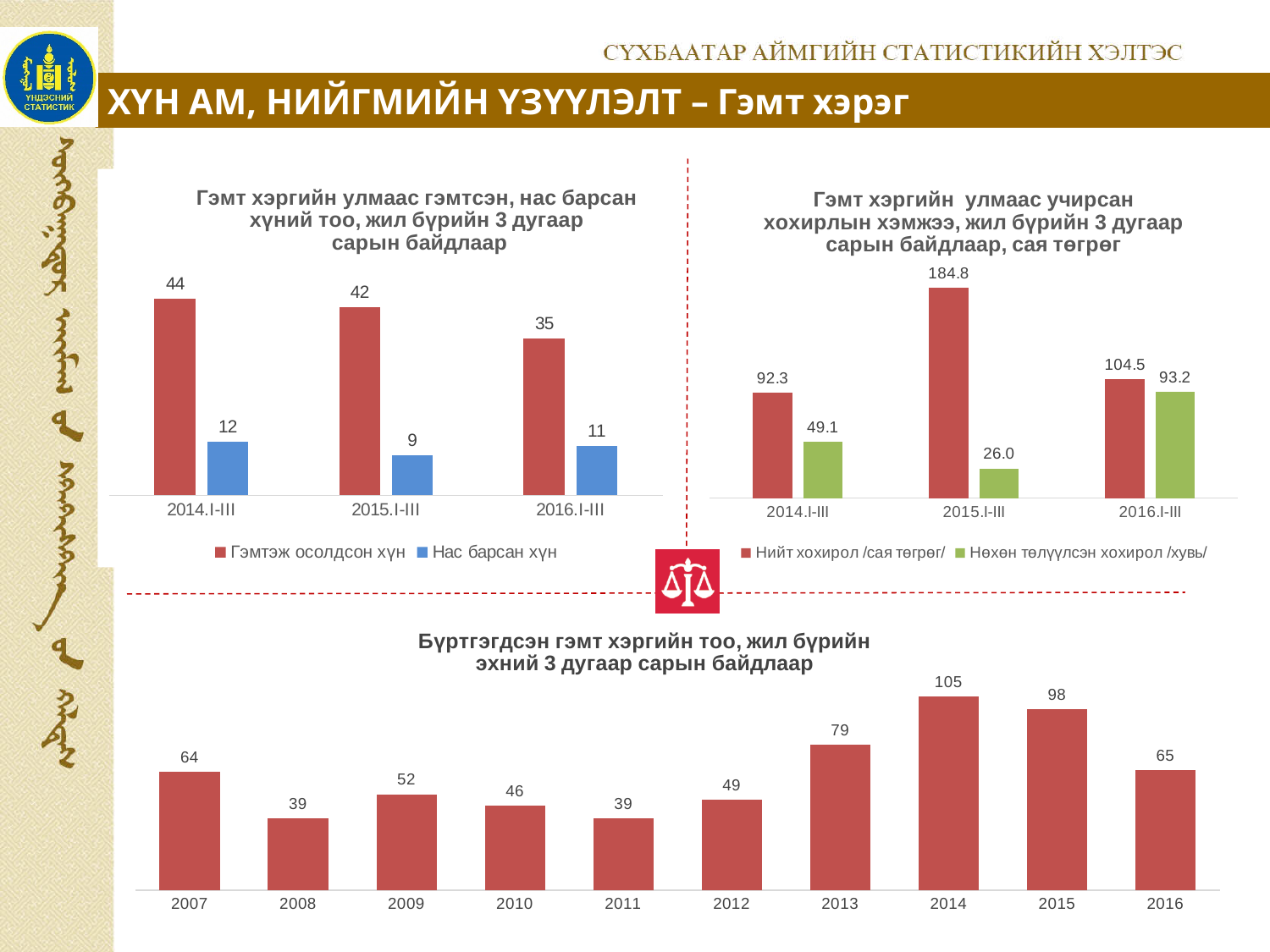
In the top-left chart (Гэмт хэргийн улмаас гэмтсэн, нас барсан хүний тоо), how many series does the legend list? 2 What kind of chart is the bottom chart (Бүртгэгдсэн гэмт хэргийн тоо)? Bar chart In the top-left chart (Гэмт хэргийн улмаас гэмтсэн, нас барсан хүний тоо), what is the difference between Гэмтэж осолдсон хүн and Нас барсан хүн in 2016.I-III? 24 In the top-right chart (Гэмт хэргийн улмаас учирсан хохирлын хэмжээ), in which period is Нөхөн төлүүлсэн хохирол the lowest? 2015.I-III In the top-right chart (Гэмт хэргийн улмаас учирсан хохирлын хэмжээ), what is the value for Нийт хохирол in 2015.I-III? 184.8 In the top-left chart (Гэмт хэргийн улмаас гэмтсэн, нас барсан хүний тоо), what is the value for Гэмтэж осолдсон хүн in 2014.I-III? 44 In the bottom chart (Бүртгэгдсэн гэмт хэргийн тоо), which year has the highest value? 2014 In the bottom chart (Бүртгэгдсэн гэмт хэргийн тоо), how many years are shown on the x axis? 10 In the top-left chart (Гэмт хэргийн улмаас гэмтсэн, нас барсан хүний тоо), what is the value for Нас барсан хүн in 2015.I-III? 9 In the bottom chart (Бүртгэгдсэн гэмт хэргийн тоо), what is the value for 2013? 79 In the top-right chart (Гэмт хэргийн улмаас учирсан хохирлын хэмжээ), which is larger in 2016.I-III: Нийт хохирол or Нөхөн төлүүлсэн хохирол? Нийт хохирол In the top-right chart (Гэмт хэргийн улмаас учирсан хохирлын хэмжээ), what is the difference between Нийт хохирол and Нөхөн төлүүлсэн хохирол in 2014.I-III? 43.2